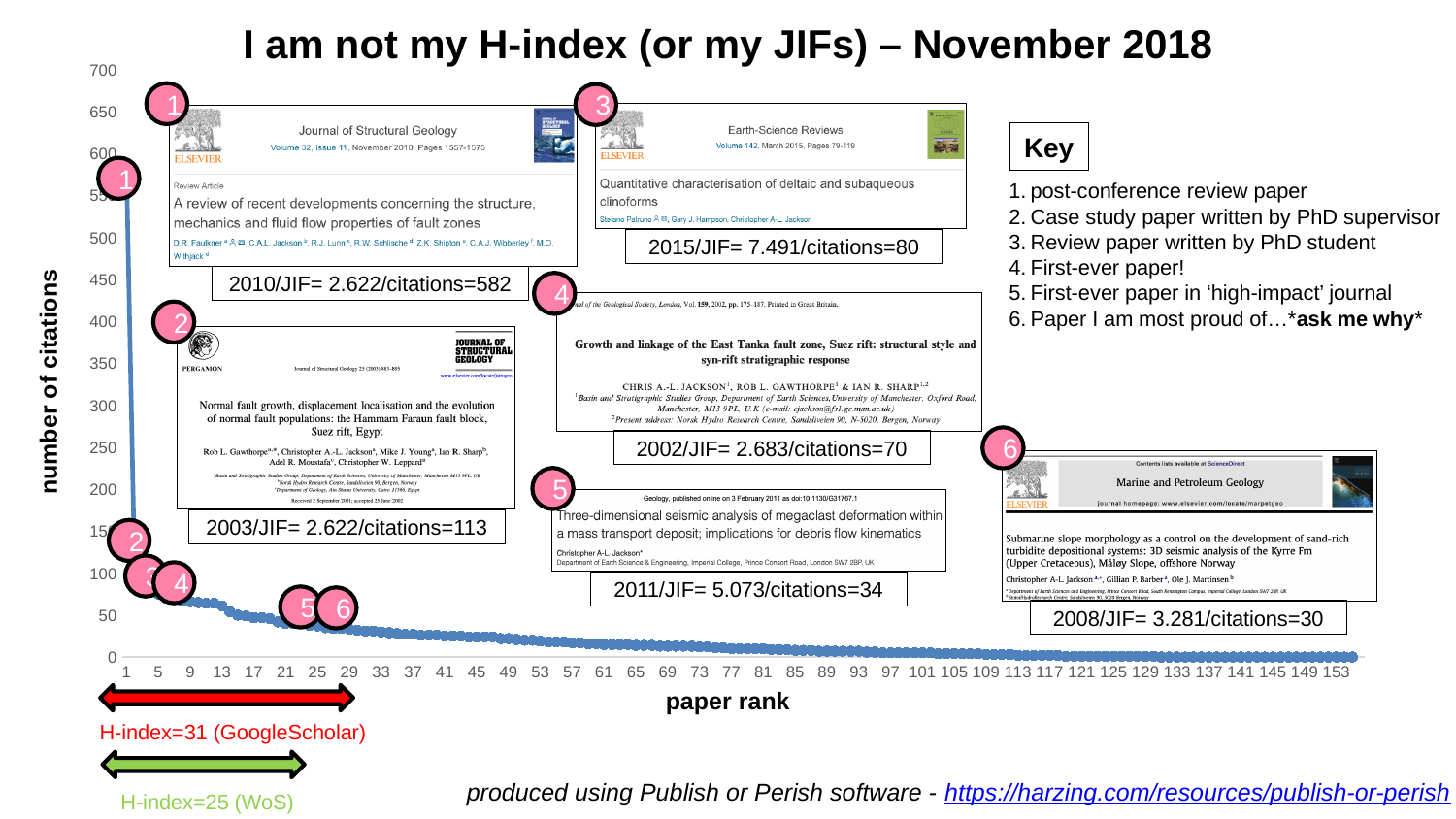
How many citations does paper 6 (the 2008 Marine and Petroleum Geology paper) have? 30 Is the number of citations for the paper at rank 1 greater or less than 500? greater What kind of chart is shown on the slide? line chart How many citations does paper 1 (the 2010 Journal of Structural Geology paper) have? 582 Which has more citations, paper 3 (2015) or paper 4 (2002)? paper 3 (2015) Which paper rank has the highest number of citations? 1 Is the number of citations for the paper at rank 153 greater or less than 50? less What is the JIF given for the 2015 Earth-Science Reviews paper (paper 3)? 7.491 Do the number of citations rise or fall as paper rank increases along the x axis? fall What is the H-index from GoogleScholar shown below the chart? 31 What is the difference in citations between paper 1 (582) and paper 2 (113)? 469 What is the label of the x axis? paper rank